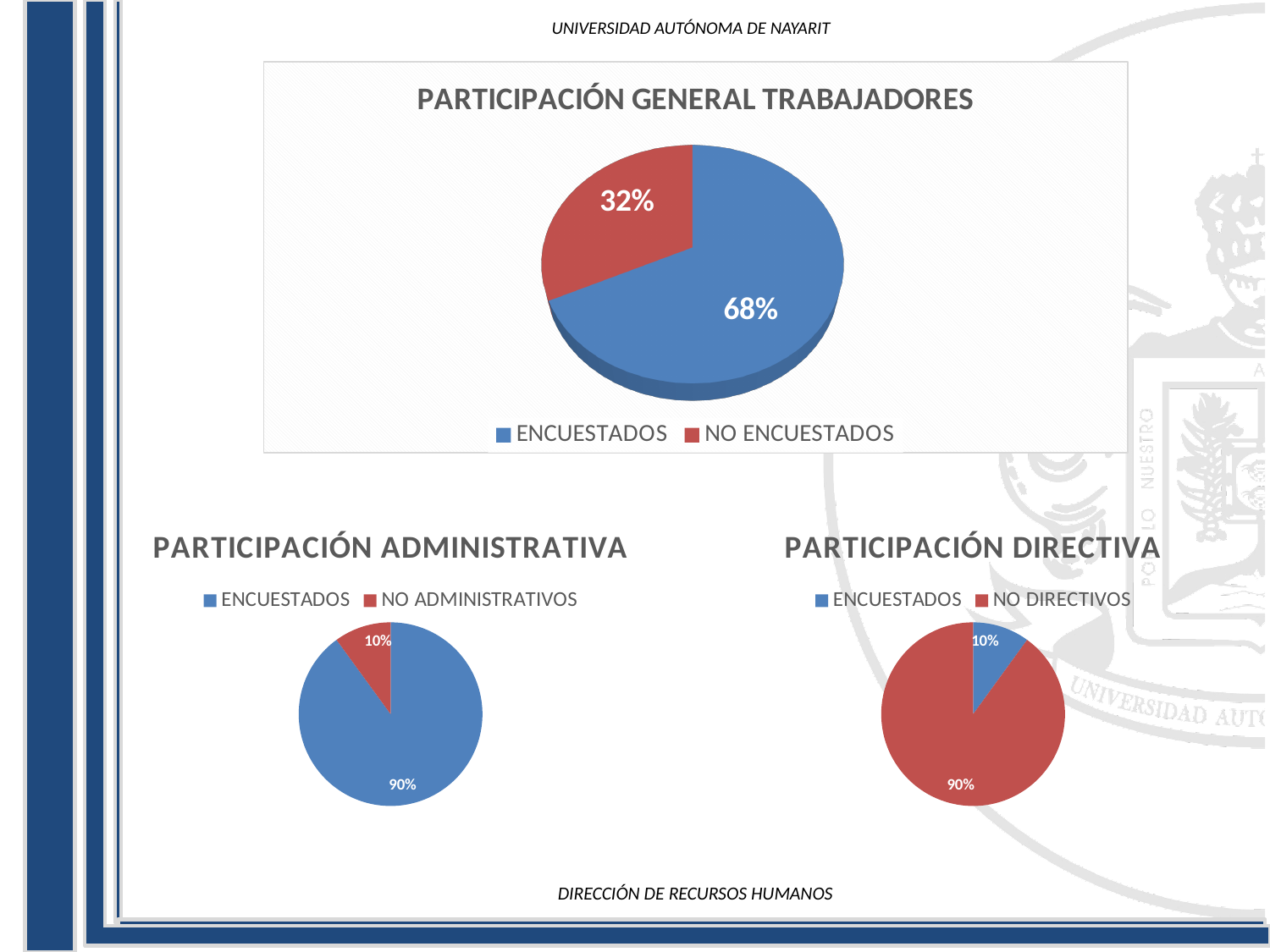
In the PARTICIPACIÓN GENERAL TRABAJADORES chart, what is the difference between the ENCUESTADOS and NO ENCUESTADOS shares? 36% In the PARTICIPACIÓN GENERAL TRABAJADORES chart, what share of the pie is NO ENCUESTADOS? 32% In the PARTICIPACIÓN GENERAL TRABAJADORES chart, what share of the pie is ENCUESTADOS? 68% In the PARTICIPACIÓN ADMINISTRATIVA chart, what share of the pie is NO ADMINISTRATIVOS? 10% How many entries does the legend of the PARTICIPACIÓN DIRECTIVA chart list? 2 In the PARTICIPACIÓN ADMINISTRATIVA chart, which slice is the smallest? NO ADMINISTRATIVOS In the PARTICIPACIÓN GENERAL TRABAJADORES chart, which slice is the largest? ENCUESTADOS In the PARTICIPACIÓN DIRECTIVA chart, which is larger, ENCUESTADOS or NO DIRECTIVOS? NO DIRECTIVOS What kind of chart is the PARTICIPACIÓN GENERAL TRABAJADORES chart? Pie chart